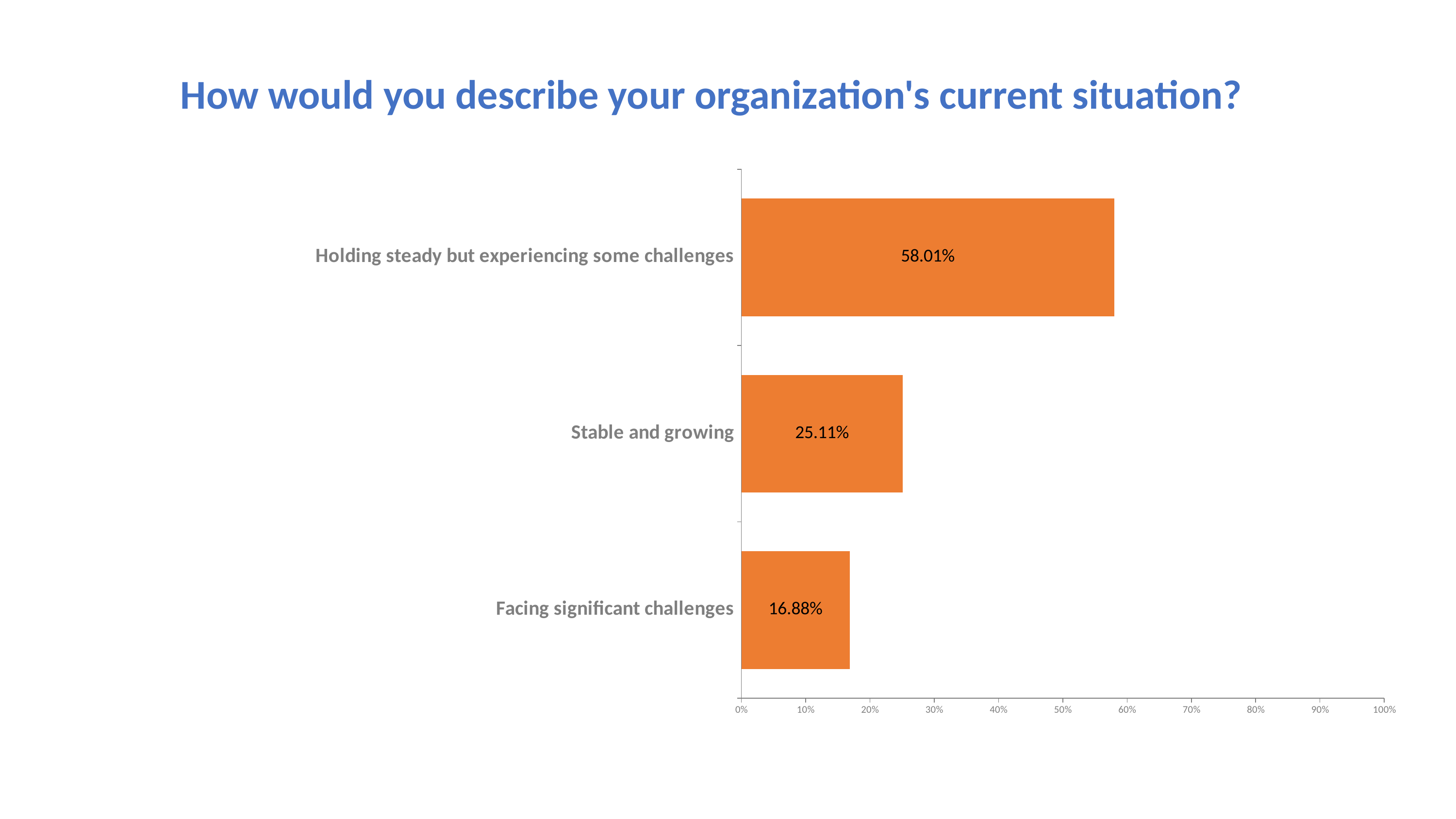
Is the value for "Holding steady but experiencing some challenges" greater or less than 50%? greater Which category has the highest value? Holding steady but experiencing some challenges What is the difference between "Stable and growing" and "Facing significant challenges"? 8.23% What percentage of respondents chose "Holding steady but experiencing some challenges"? 58.01% Which is larger, "Stable and growing" or "Facing significant challenges"? Stable and growing How many categories are shown in the chart? 3 Which category has the lowest value? Facing significant challenges What is the value for "Stable and growing"? 25.11% What is the value for "Facing significant challenges"? 16.88% What kind of chart is shown on the slide? Bar chart What is the title of the chart? How would you describe your organization's current situation? What is the difference between "Holding steady but experiencing some challenges" and "Stable and growing"? 32.90%